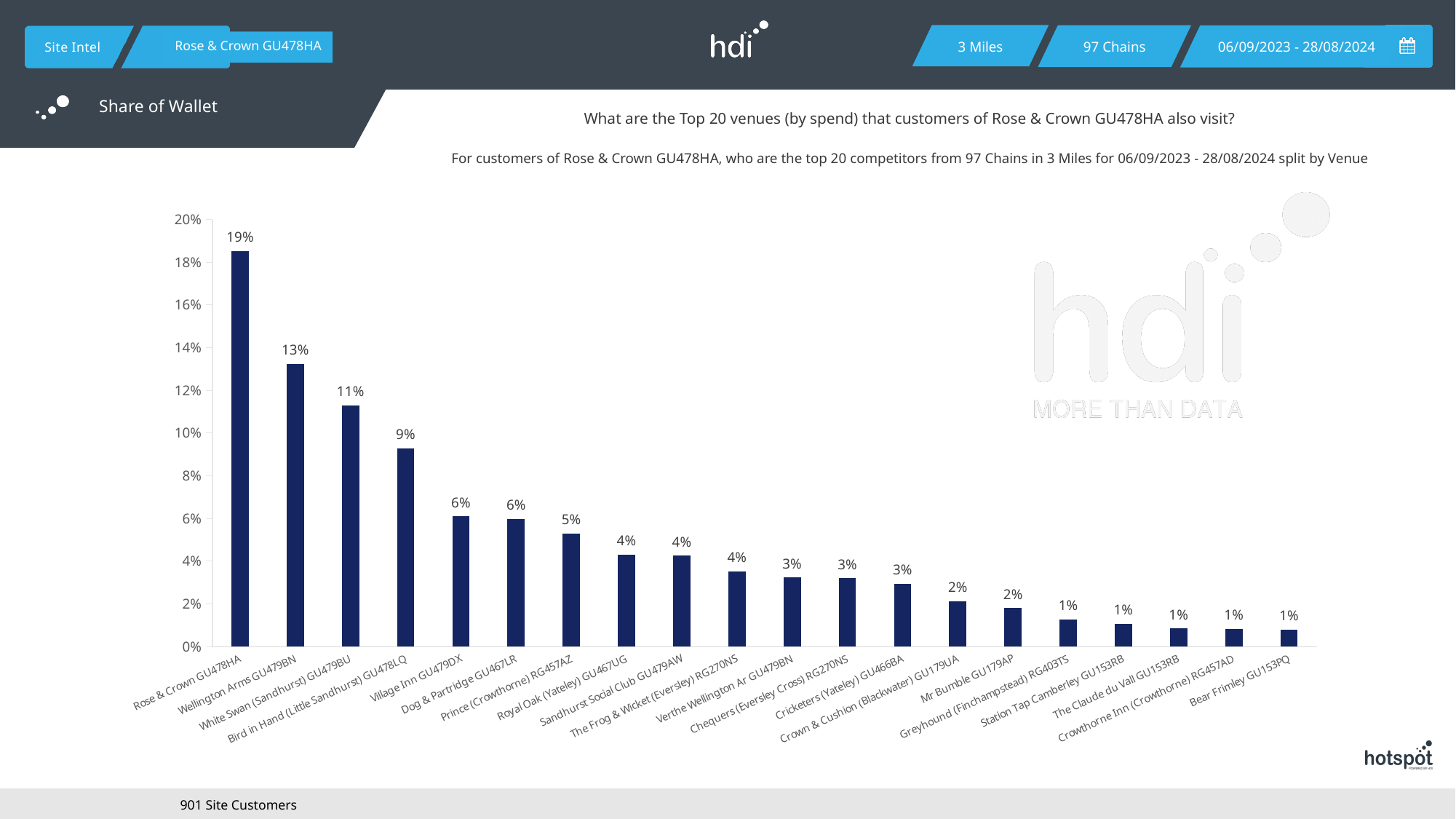
How many venues are shown on the chart? 20 What is the value for Wellington Arms GU479BN? 13% What is the value for Prince (Crowthorne) RG457AZ? 5% What is the value for Bird in Hand (Little Sandhurst) GU478LQ? 9% What is the value for Mr Bumble GU179AP? 2% Which is larger, the value for White Swan (Sandhurst) GU479BU or the value for Village Inn GU479DX? White Swan (Sandhurst) GU479BU What is the value for Rose & Crown GU478HA? 19% What kind of chart is shown on the slide? bar chart Is the value for Rose & Crown GU478HA greater or less than 18%? greater Do the values rise or fall from left to right along the x axis? fall What is the difference between the values for Rose & Crown GU478HA and Wellington Arms GU479BN? 6% Which venue has the highest value? Rose & Crown GU478HA